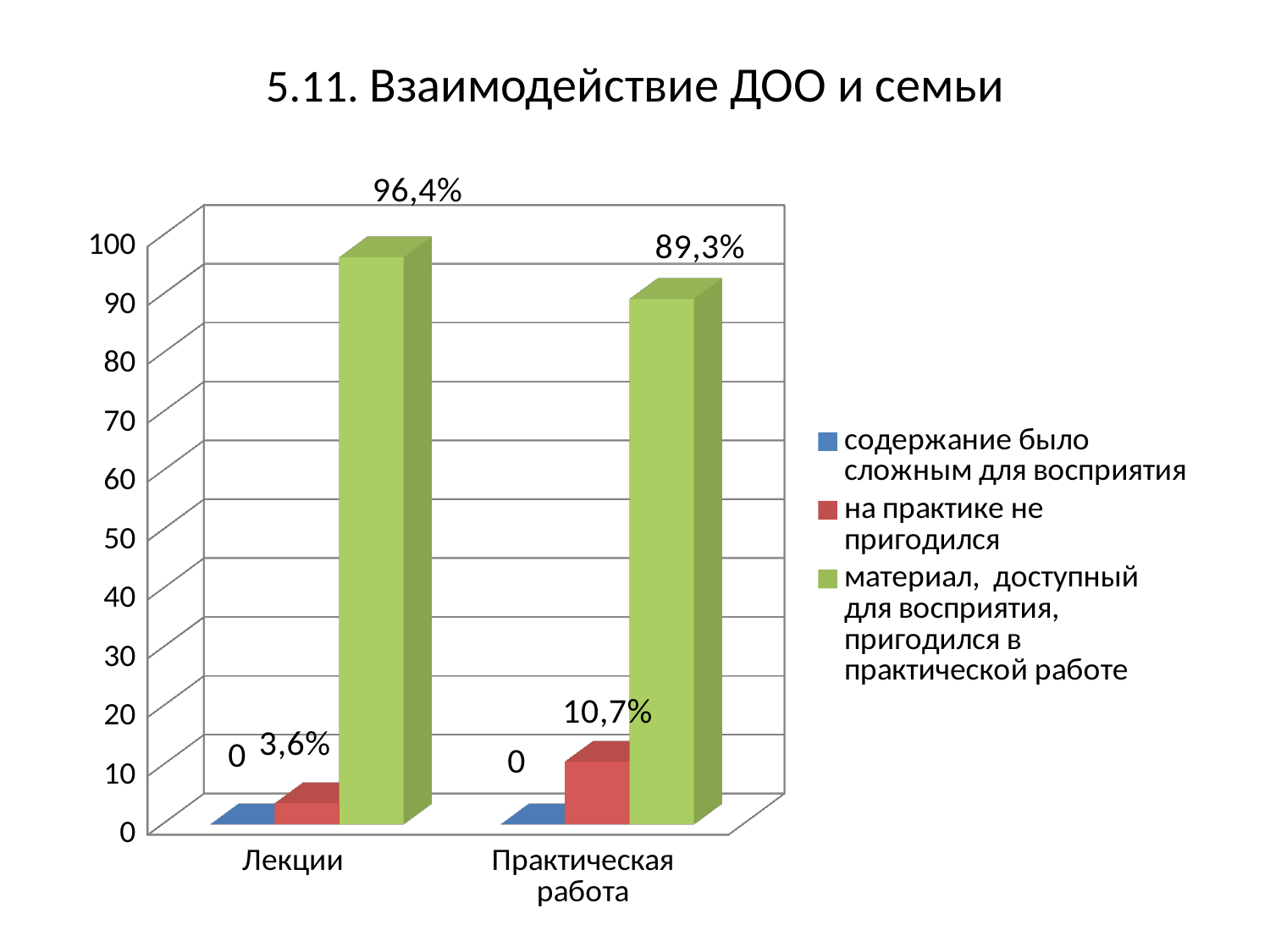
What is the value for "материал, доступный для восприятия, пригодился в практической работе" in the "Лекции" category? 96,4% What is the difference between the "материал, доступный для восприятия, пригодился в практической работе" values for "Лекции" and "Практическая работа"? 7,1% What kind of chart is shown on the slide? Bar chart What is the difference between the "на практике не пригодился" values for "Практическая работа" and "Лекции"? 7,1% What is the value for "на практике не пригодился" in the "Практическая работа" category? 10,7% Which category has the higher value for "на практике не пригодился"? Практическая работа How many series does the legend list? 3 Which category has the higher value for "материал, доступный для восприятия, пригодился в практической работе"? Лекции What is the value for "материал, доступный для восприятия, пригодился в практической работе" in the "Практическая работа" category? 89,3% What is the value for "на практике не пригодился" in the "Лекции" category? 3,6% How many categories are shown on the x axis? 2 What is the value for "содержание было сложным для восприятия" in the "Лекции" category? 0